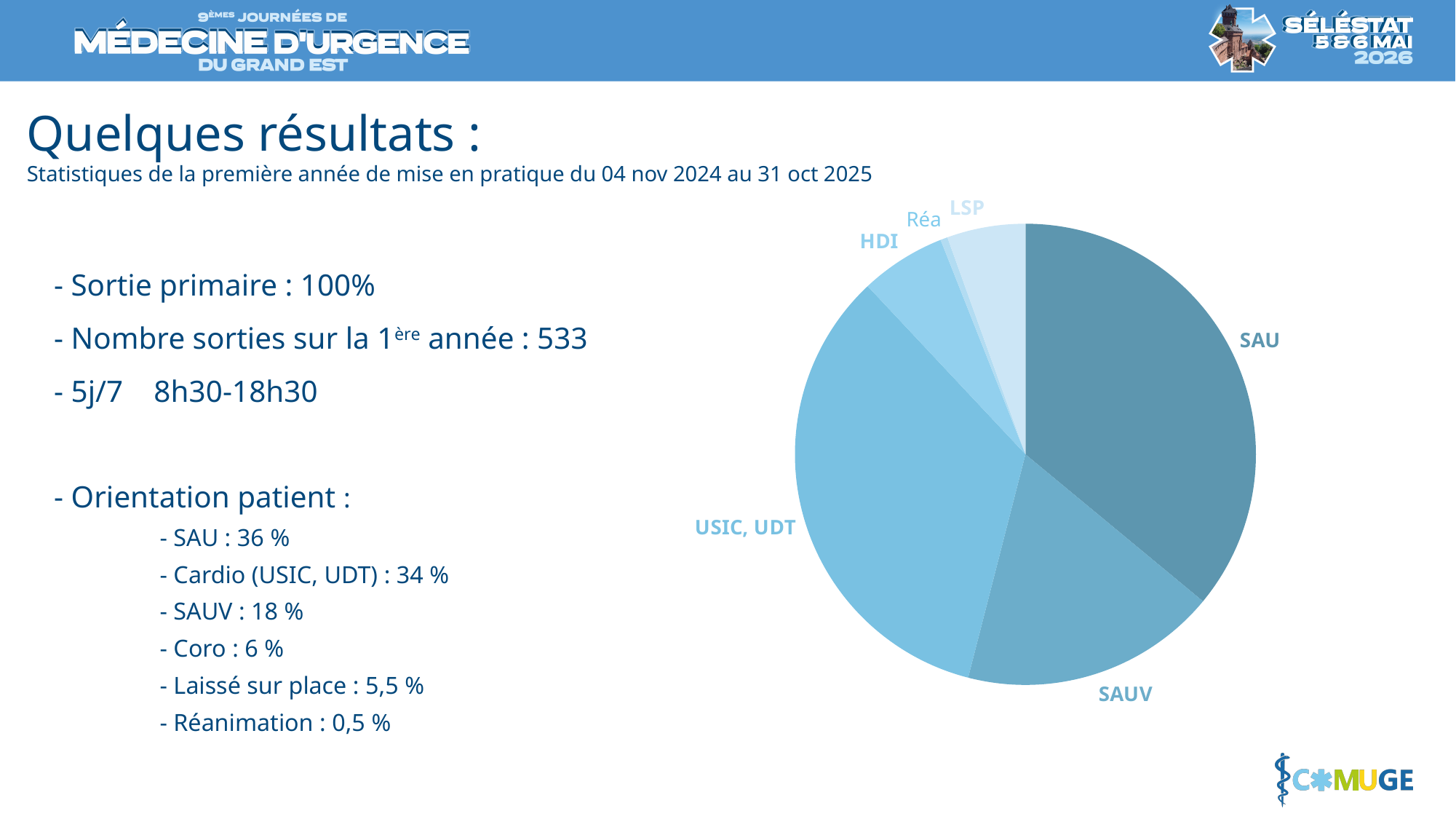
Which slice of the pie chart is the largest? SAU What kind of chart is shown on the slide? pie chart Which slice label appears at the top of the pie chart, next to Réa? LSP According to the slide, what share of patient orientation goes to SAU? 36 % What is the difference in percentage points between the SAU share and the SAUV share given on the slide? 18 % How many slices does the pie chart have? 6 Which slice is larger in the pie chart, HDI or SAUV? SAUV Which slice of the pie chart is the smallest? Réa Which slice is larger in the pie chart, LSP or Réa? LSP According to the slide, what share of patient orientation goes to Cardio (USIC, UDT)? 34 % Which slice is larger in the pie chart, SAUV or USIC, UDT? USIC, UDT According to the slide, what share of patient orientation goes to SAUV? 18 %